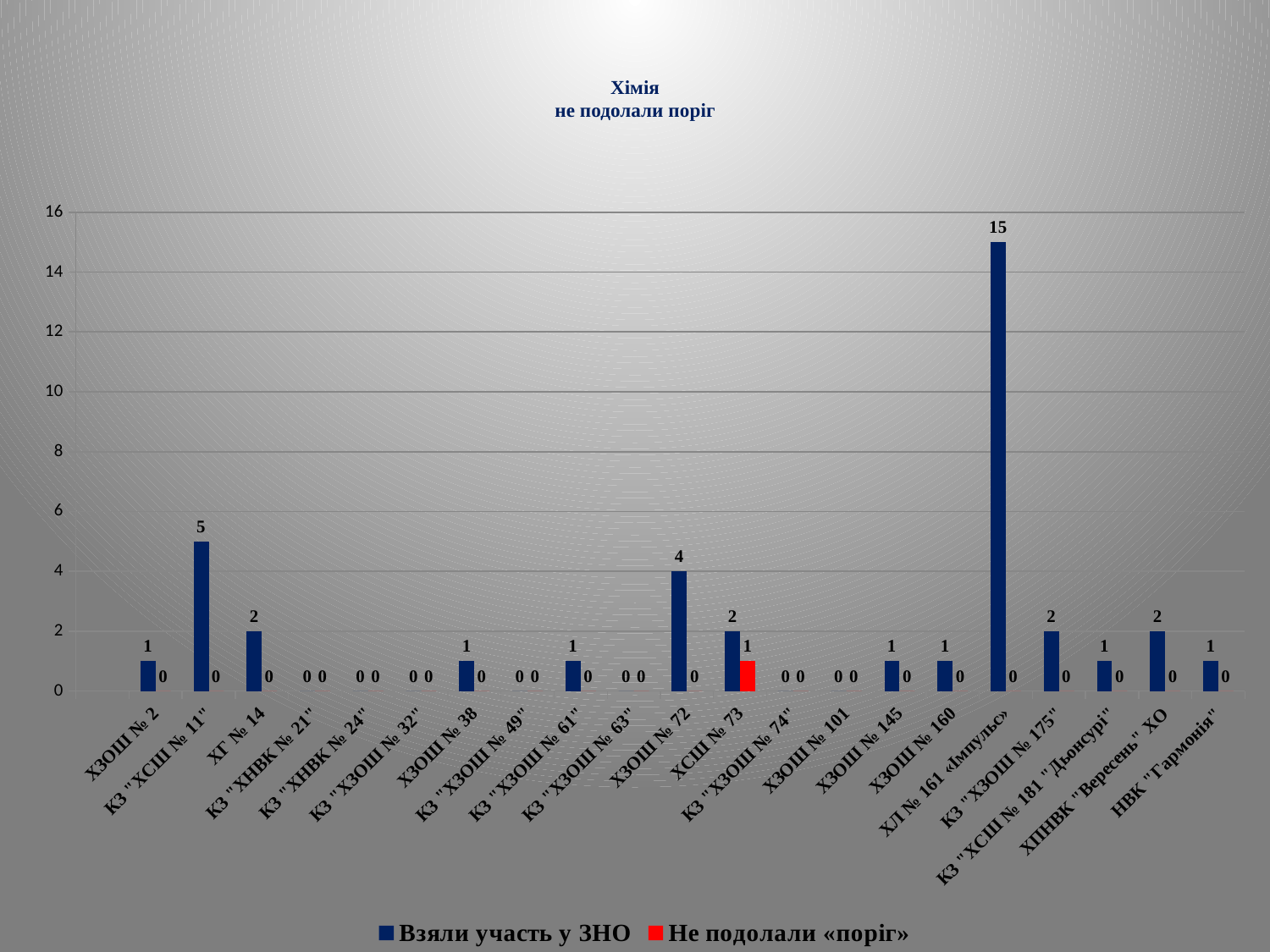
Which category is the only one with a non-zero value in the 'Не подолали «поріг»' series? ХСШ № 73 Which category has the highest value in the 'Взяли участь у ЗНО' series? ХЛ № 161 «Імпульс» What value does the 'Взяли участь у ЗНО' series show for КЗ "ХСШ № 11"? 5 Which is larger in the 'Взяли участь у ЗНО' series: ХЗОШ № 72 or ХГ № 14? ХЗОШ № 72 What is the value for ХЗОШ № 72 in the 'Взяли участь у ЗНО' series? 4 How many series does the legend list? 2 What colour represents the 'Не подолали «поріг»' series? red What value does the 'Не подолали «поріг»' series show for ХСШ № 73? 1 What value does the 'Взяли участь у ЗНО' series show for ХЛ № 161 «Імпульс»? 15 How many categories are shown on the x axis? 21 What kind of chart is shown on the slide? bar chart What is the difference between the 'Взяли участь у ЗНО' values for ХЛ № 161 «Імпульс» and КЗ "ХСШ № 11"? 10